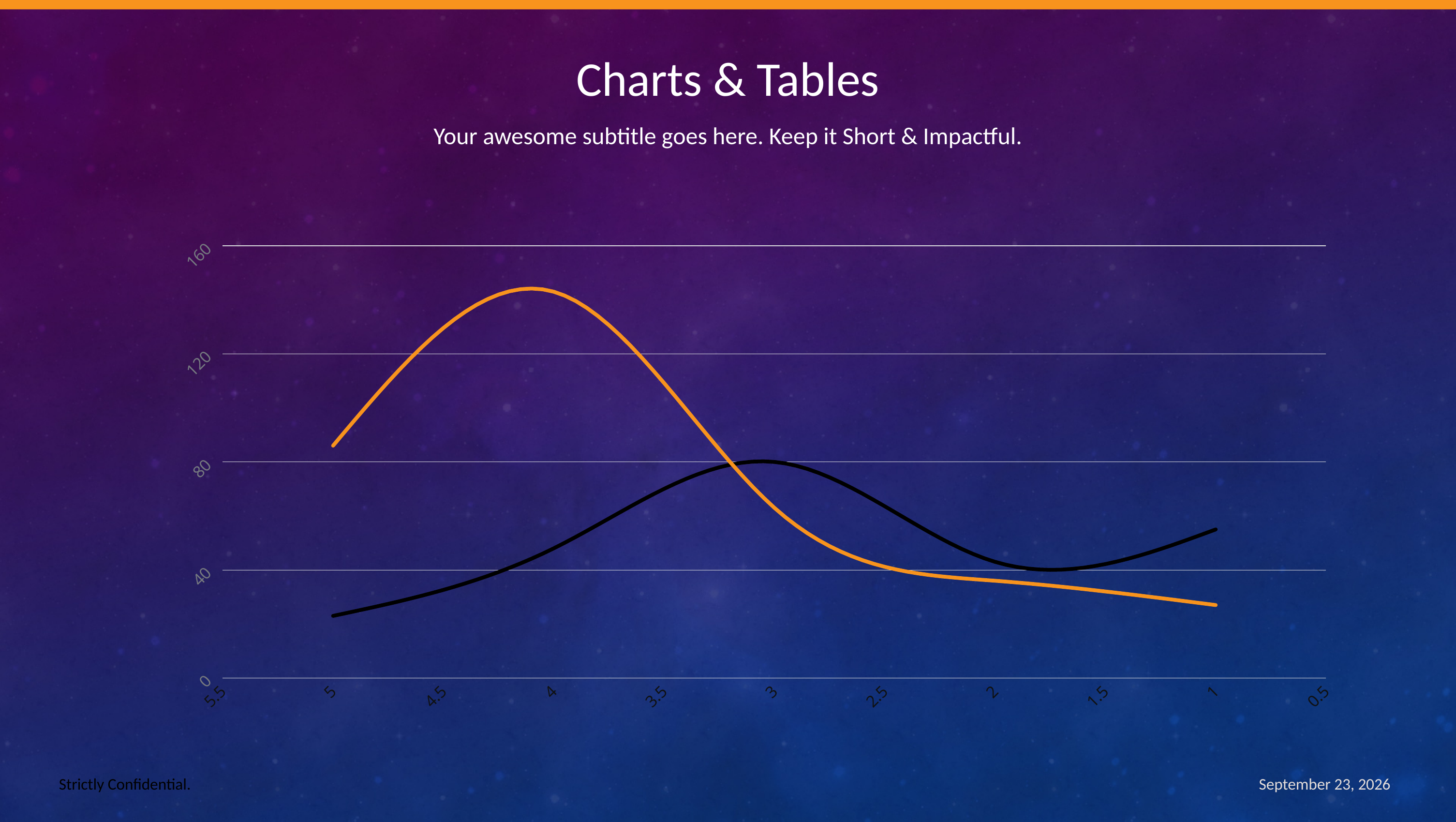
Is the value of the orange line at x = 1 greater or less than 40? less At x = 1, which line has the larger value, the orange line or the black line? black line Is the value of the black line at x = 5 greater or less than 40? less What kind of chart is shown on the slide? line chart Which line reaches the highest value anywhere on the chart? orange line How many lines are plotted on the chart? 2 What is the highest value labelled on the vertical axis? 160 Is the value of the black line at x = 4 greater or less than 80? less What colours are the two lines on the chart? orange and black At x = 4, which line has the larger value, the orange line or the black line? orange line